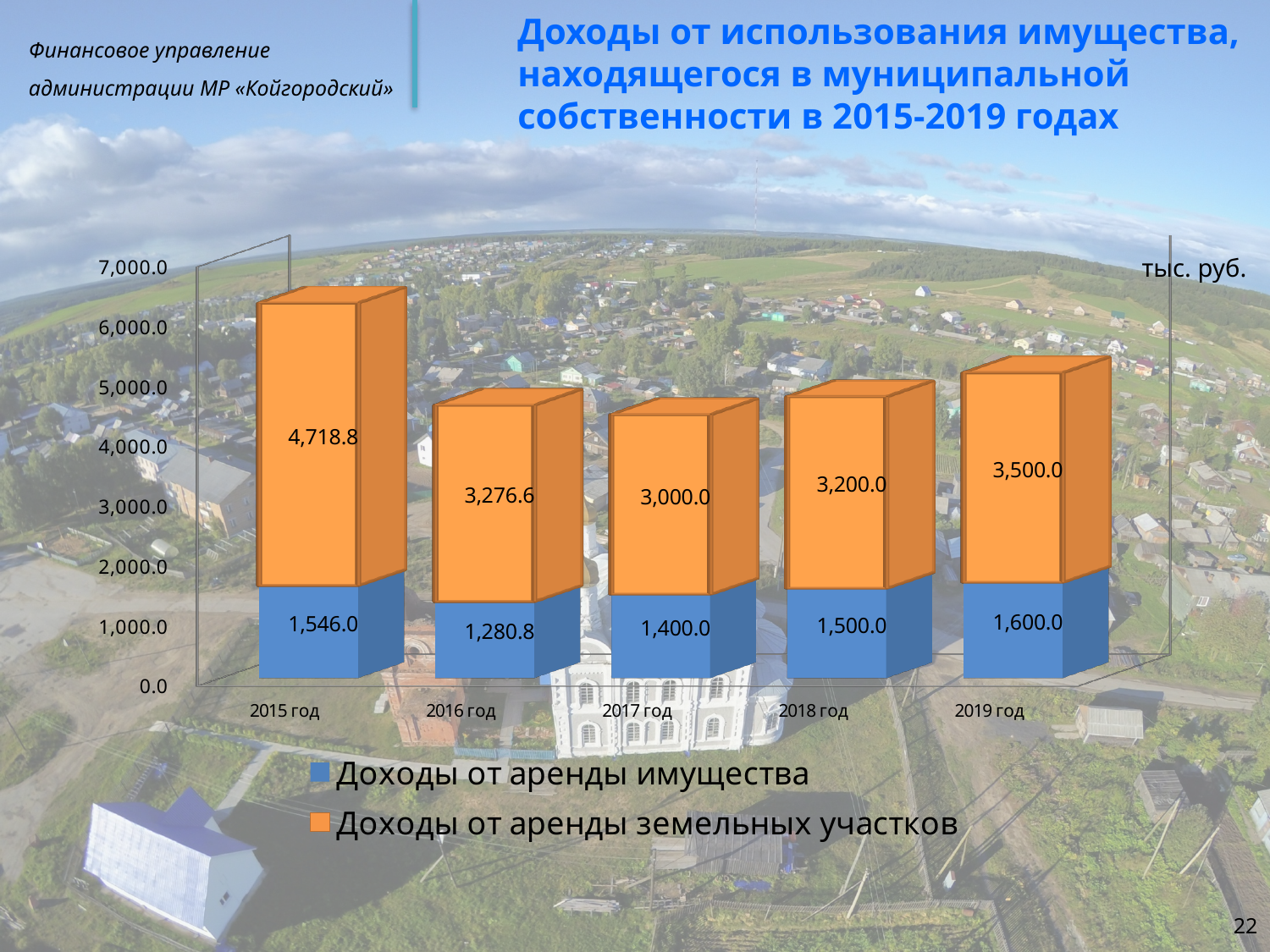
How many years are shown on the x axis? 5 What is the value of "Доходы от аренды земельных участков" for 2015 год? 4,718.8 Which year has the lowest value for "Доходы от аренды имущества"? 2016 год What kind of chart is shown on the slide? Stacked bar chart What is the value of "Доходы от аренды имущества" for 2016 год? 1,280.8 How many series does the legend list? 2 What is the difference between "Доходы от аренды земельных участков" in 2019 год and 2018 год? 300.0 What is the total of the stacked bar for 2015 год? 6,264.8 What is the total of the stacked bar for 2017 год? 4,400.0 Which is larger: "Доходы от аренды имущества" in 2015 год or in 2019 год? 2019 год What is the value of "Доходы от аренды земельных участков" for 2019 год? 3,500.0 Which year has the highest value for "Доходы от аренды земельных участков"? 2015 год